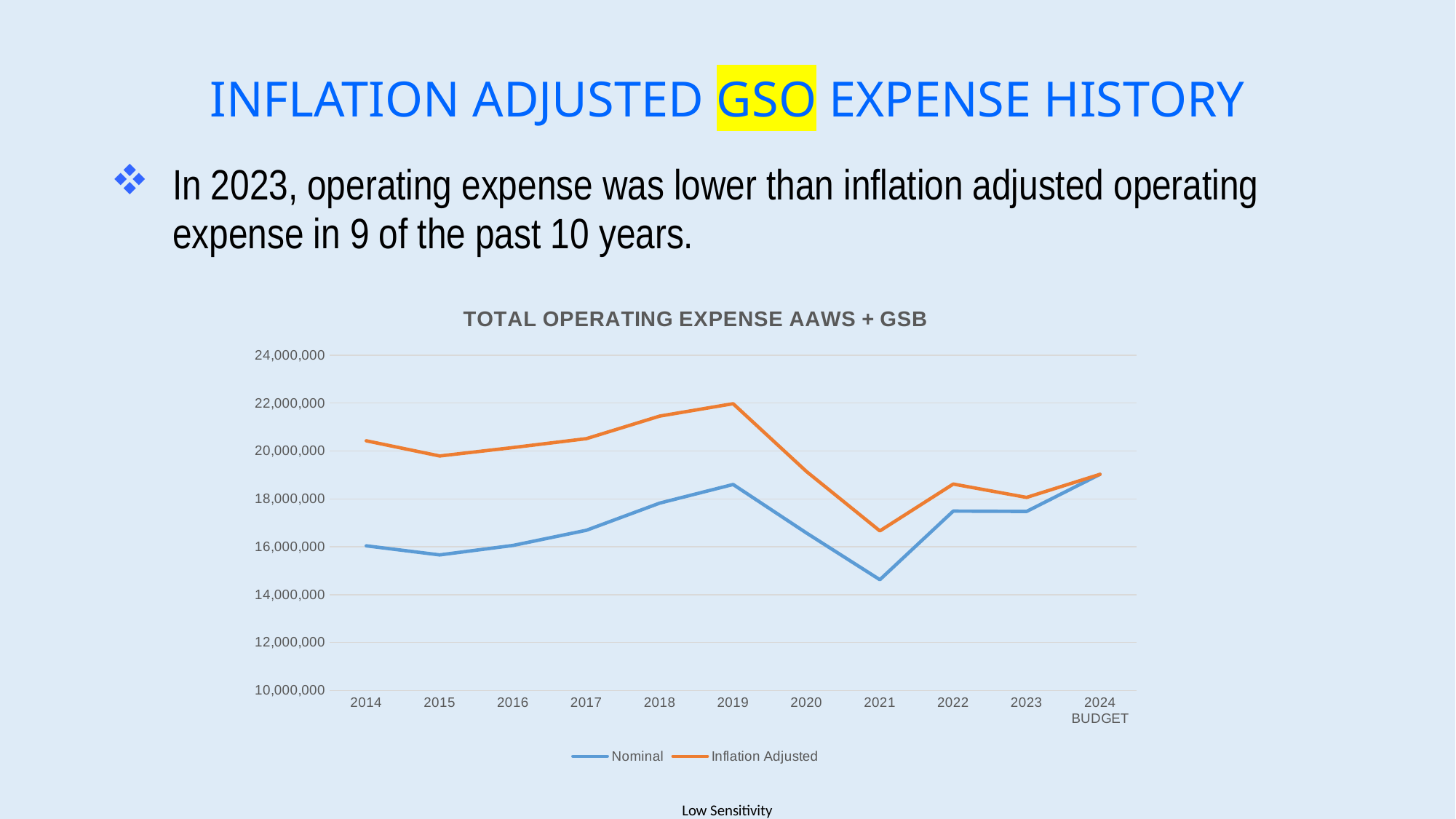
In 2019, which series has the larger value, Nominal or Inflation Adjusted? Inflation Adjusted Is the Nominal value for 2021 greater or less than 16,000,000? less How many series does the chart's legend list? 2 In which year does the Inflation Adjusted series reach its highest value? 2019 What kind of chart is shown on the slide? line chart Is the Inflation Adjusted value for 2018 greater or less than 20,000,000? greater Does the Nominal series rise or fall from 2019 to 2021? fall How many points are plotted along the x axis of the chart? 11 What is the title of the chart? TOTAL OPERATING EXPENSE AAWS + GSB In which year does the Nominal series reach its lowest value? 2021 Which series is drawn in orange? Inflation Adjusted In which year does the Inflation Adjusted series reach its lowest value? 2021